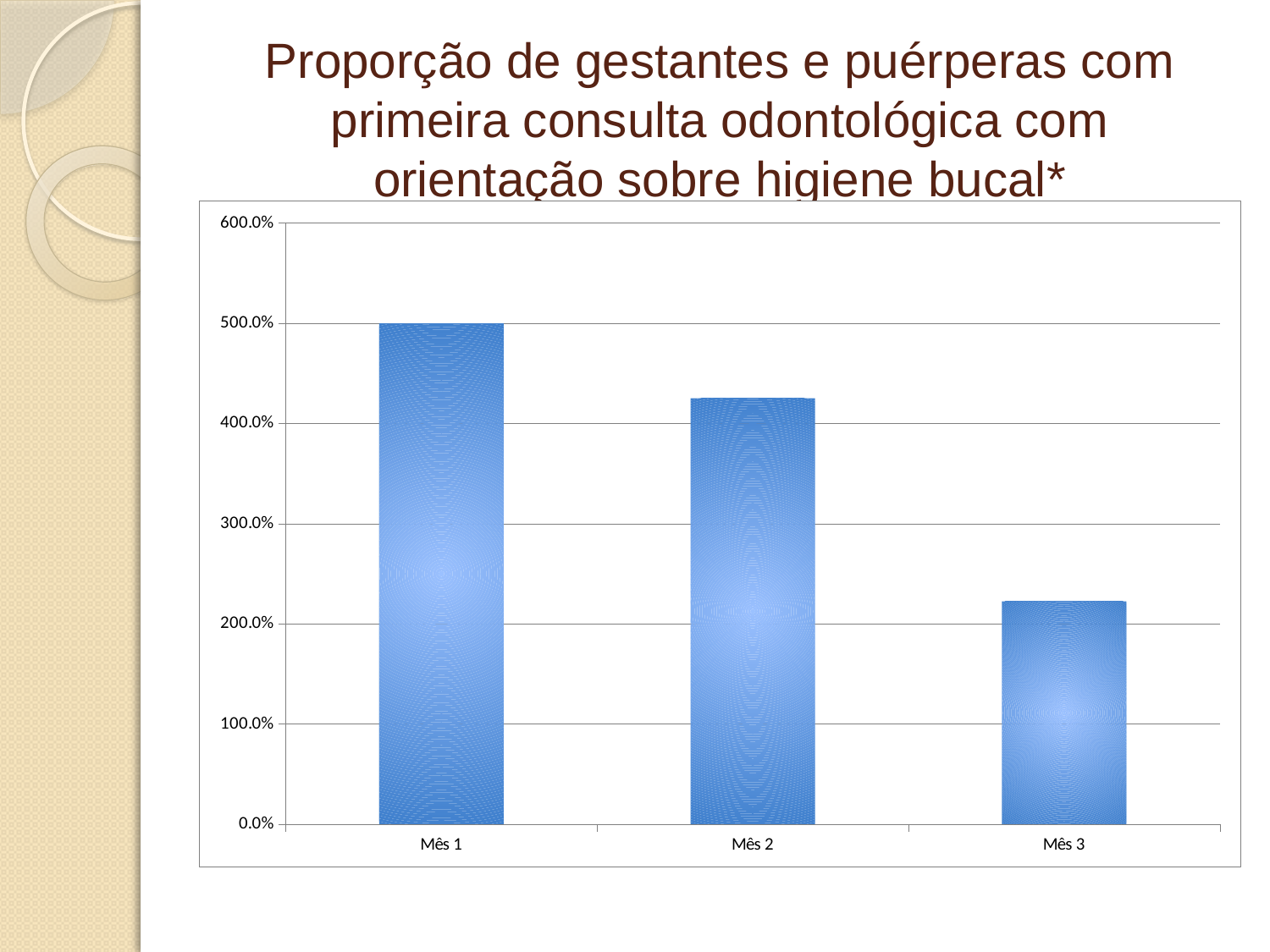
Do the values rise or fall from Mês 1 to Mês 3? fall What is the value for Mês 1? 500.0% Is the value for Mês 3 greater or less than 300.0%? less Which month has the lowest value on the chart? Mês 3 Which is larger, the value for Mês 1 or the value for Mês 2? Mês 1 Is the value for Mês 2 greater or less than 500.0%? less Which month has the highest value on the chart? Mês 1 What is the highest value shown on the vertical axis? 600.0% Is the value for Mês 3 greater or less than 200.0%? greater What kind of chart is shown on the slide? bar chart How many categories (months) are plotted on the chart? 3